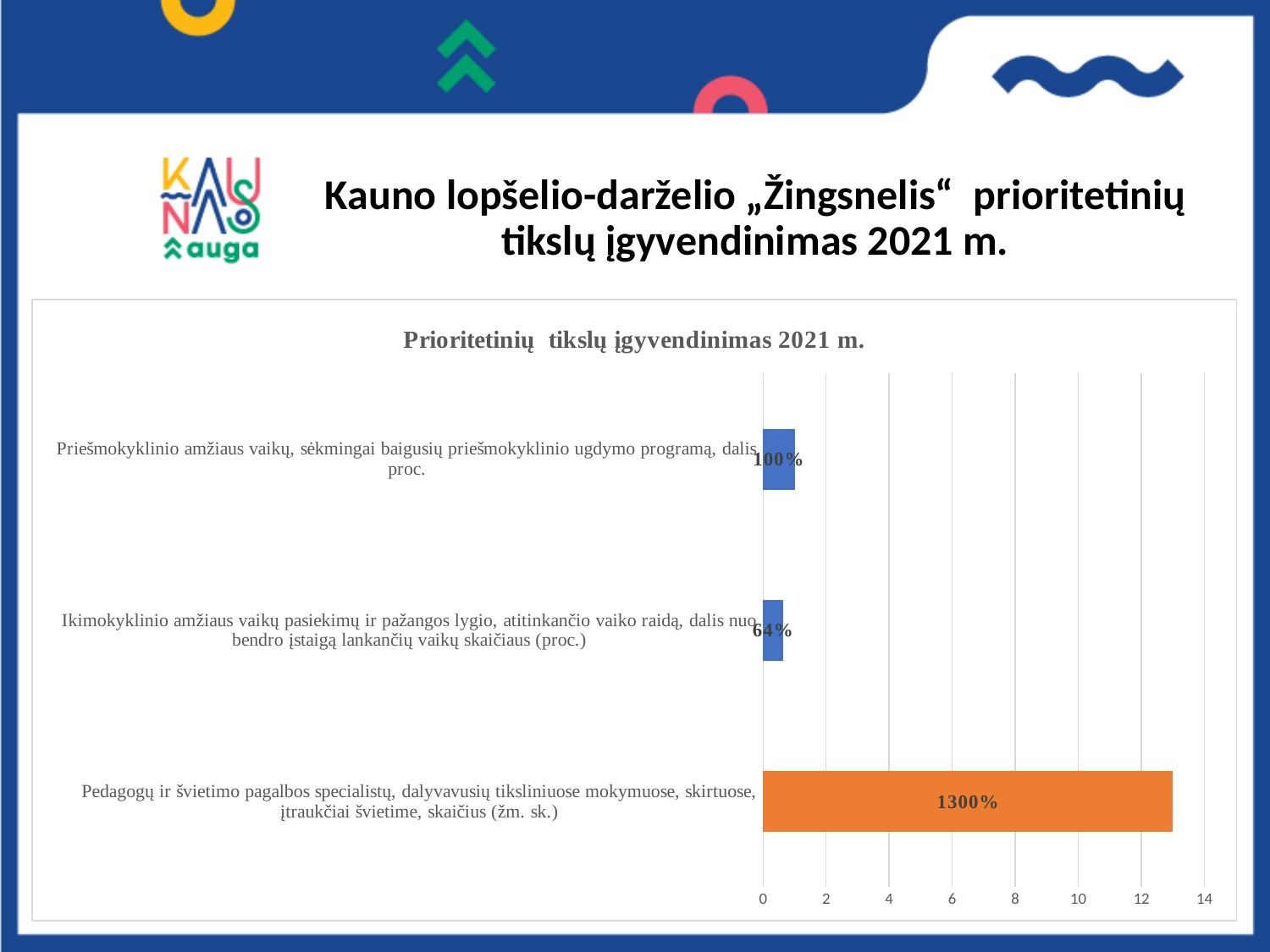
Which category has the lowest value in the chart? Ikimokyklinio amžiaus vaikų pasiekimų ir pažangos lygio, atitinkančio vaiko raidą, dalis nuo bendro įstaigą lankančių vaikų skaičiaus (proc.) What value is shown for the category "Priešmokyklinio amžiaus vaikų, sėkmingai baigusių priešmokyklinio ugdymo programą, dalis proc."? 100% Which is larger: the value for "Priešmokyklinio amžiaus vaikų..." or the value for "Ikimokyklinio amžiaus vaikų..."? Priešmokyklinio amžiaus vaikų... Which category has the highest value in the chart? Pedagogų ir švietimo pagalbos specialistų, dalyvavusių tiksliniuose mokymuose, skirtuose, įtraukčiai švietime, skaičius (žm. sk.) What value is shown for the category "Pedagogų ir švietimo pagalbos specialistų, dalyvavusių tiksliniuose mokymuose..."? 1300% What value is shown for the category "Ikimokyklinio amžiaus vaikų pasiekimų ir pažangos lygio, atitinkančio vaiko raidą, dalis..."? 64% How many categories are shown in the chart? 3 What is the difference between the values for the "Priešmokyklinio amžiaus vaikų..." category and the "Ikimokyklinio amžiaus vaikų..." category? 36% What type of chart is shown on the slide? bar chart What is the title of the chart? Prioritetinių tikslų įgyvendinimas 2021 m. Is the bar for "Priešmokyklinio amžiaus vaikų..." greater or less than 2 on the axis? less Is the bar for "Pedagogų ir švietimo pagalbos specialistų..." greater or less than 12 on the axis? greater